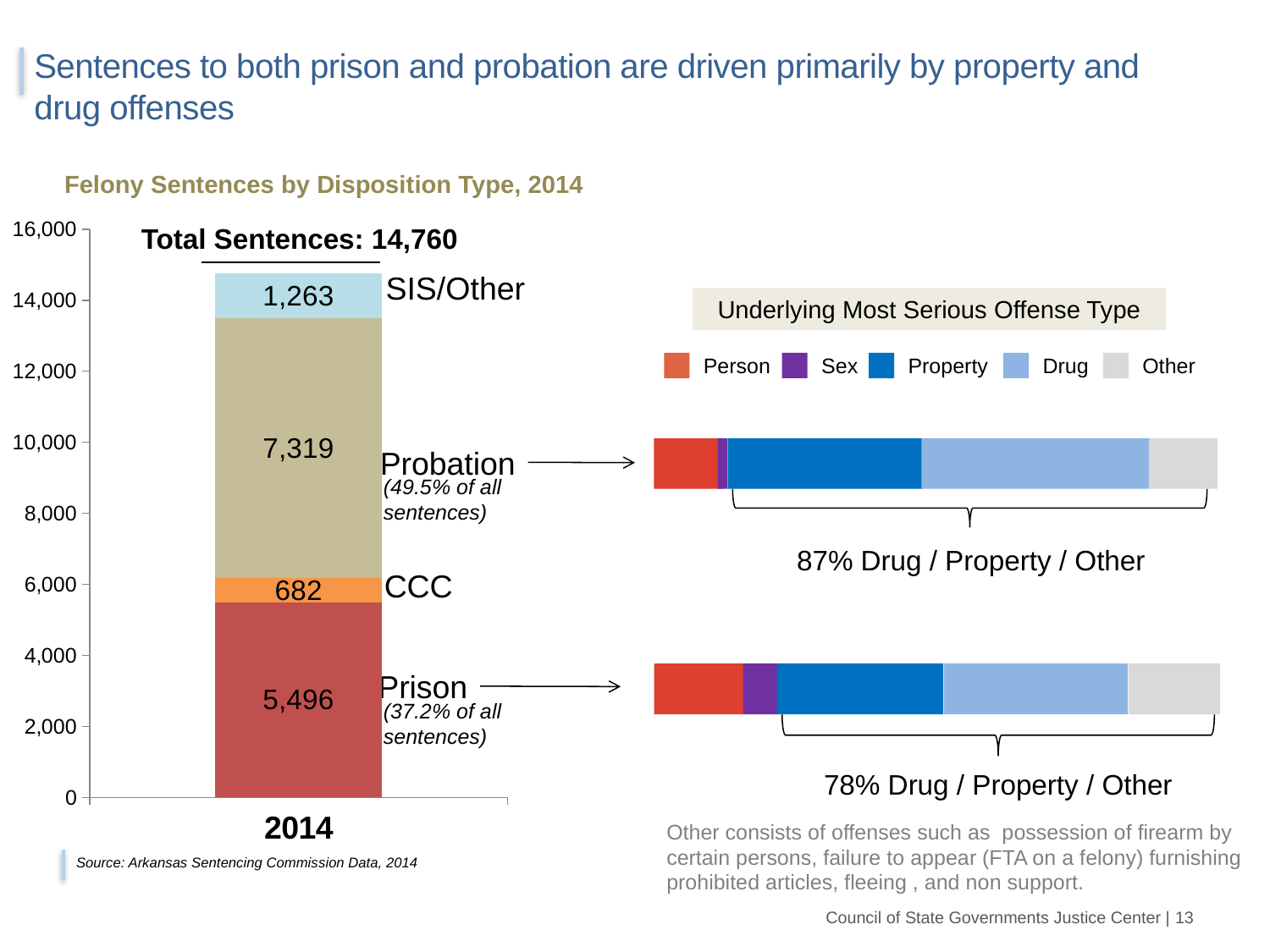
In the 'Underlying Most Serious Offense Type' bars, what share of Prison sentences is Drug / Property / Other? 78% In the 'Felony Sentences by Disposition Type, 2014' chart, how many segments make up the stacked bar? 4 In the 'Felony Sentences by Disposition Type, 2014' chart, what percentage of all sentences does Probation represent? 49.5% In the 'Felony Sentences by Disposition Type, 2014' chart, what is the value for SIS/Other? 1,263 In the 'Felony Sentences by Disposition Type, 2014' chart, how many sentences were to Probation? 7,319 In the 'Felony Sentences by Disposition Type, 2014' chart, how many sentences were to Prison? 5,496 In the 'Felony Sentences by Disposition Type, 2014' chart, what is the difference between the Probation and Prison values? 1,823 In the 'Felony Sentences by Disposition Type, 2014' chart, what is the total of the stacked bar for 2014? 14,760 In the 'Felony Sentences by Disposition Type, 2014' chart, what is the value for CCC? 682 How many offense types does the 'Underlying Most Serious Offense Type' legend list? 5 In the 'Felony Sentences by Disposition Type, 2014' chart, which disposition type has the smallest number of sentences? CCC In the 'Felony Sentences by Disposition Type, 2014' chart, which disposition type has the largest number of sentences? Probation